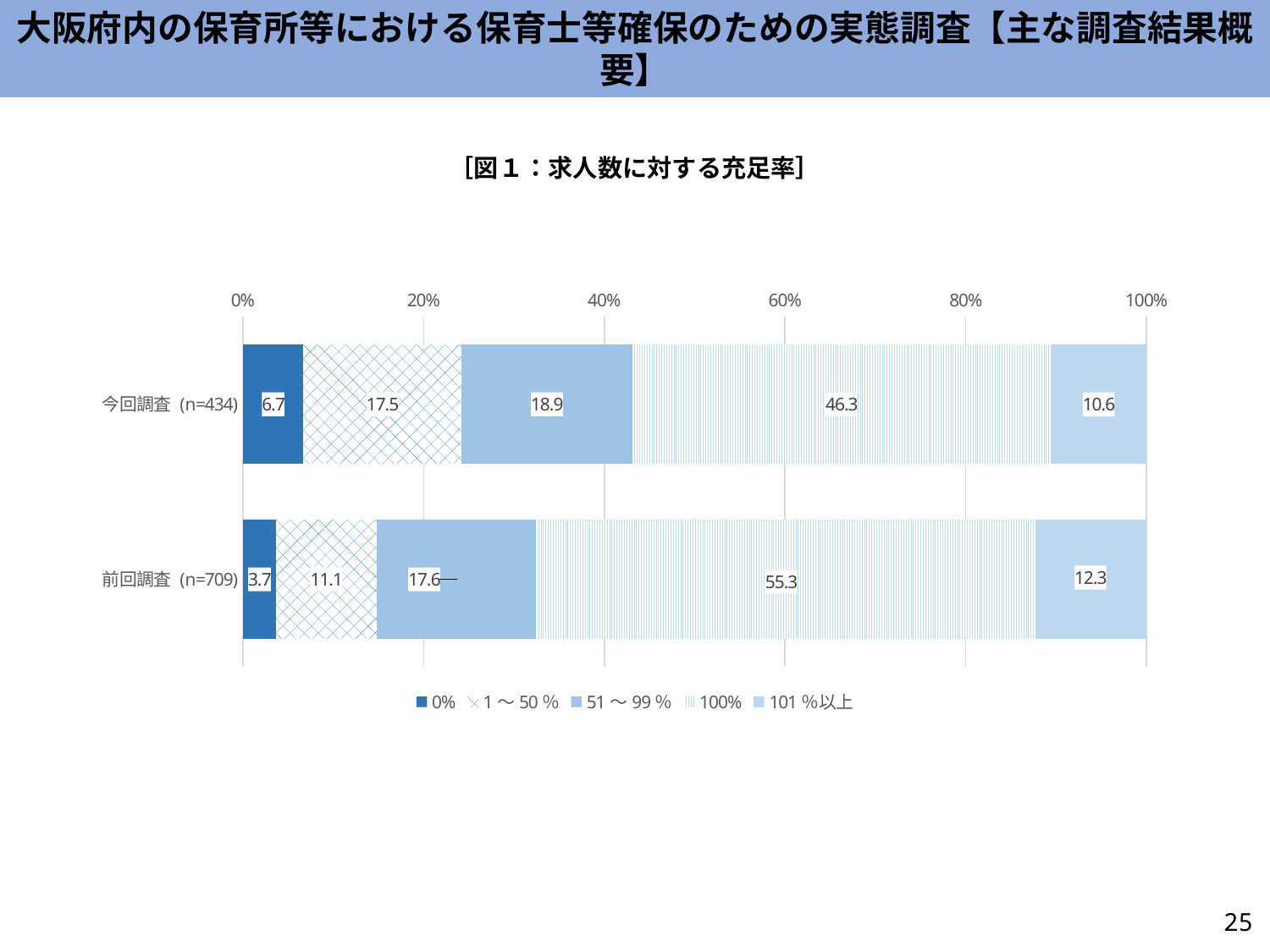
Which segment is the largest for 前回調査 (n=709)? 100% What type of chart is shown in 図1 (求人数に対する充足率)? Stacked bar chart How many categories (survey rows) are plotted in the chart? 2 How many series does the legend list in the chart? 5 What is the value of the 1～50% segment for 今回調査 (n=434)? 17.5 What is the value of the 0% segment for 前回調査 (n=709)? 3.7 Which survey has the larger value for the 51～99% segment, 今回調査 (n=434) or 前回調査 (n=709)? 今回調査 (n=434) What is the value of the 100% segment for 今回調査 (n=434)? 46.3 What is the difference between the 100% segment values of 前回調査 (n=709) and 今回調査 (n=434)? 9.0 What is the total of all segments in the 今回調査 (n=434) bar? 100.0 Which segment is the smallest for 今回調査 (n=434)? 0% What is the value of the 101%以上 segment for 前回調査 (n=709)? 12.3